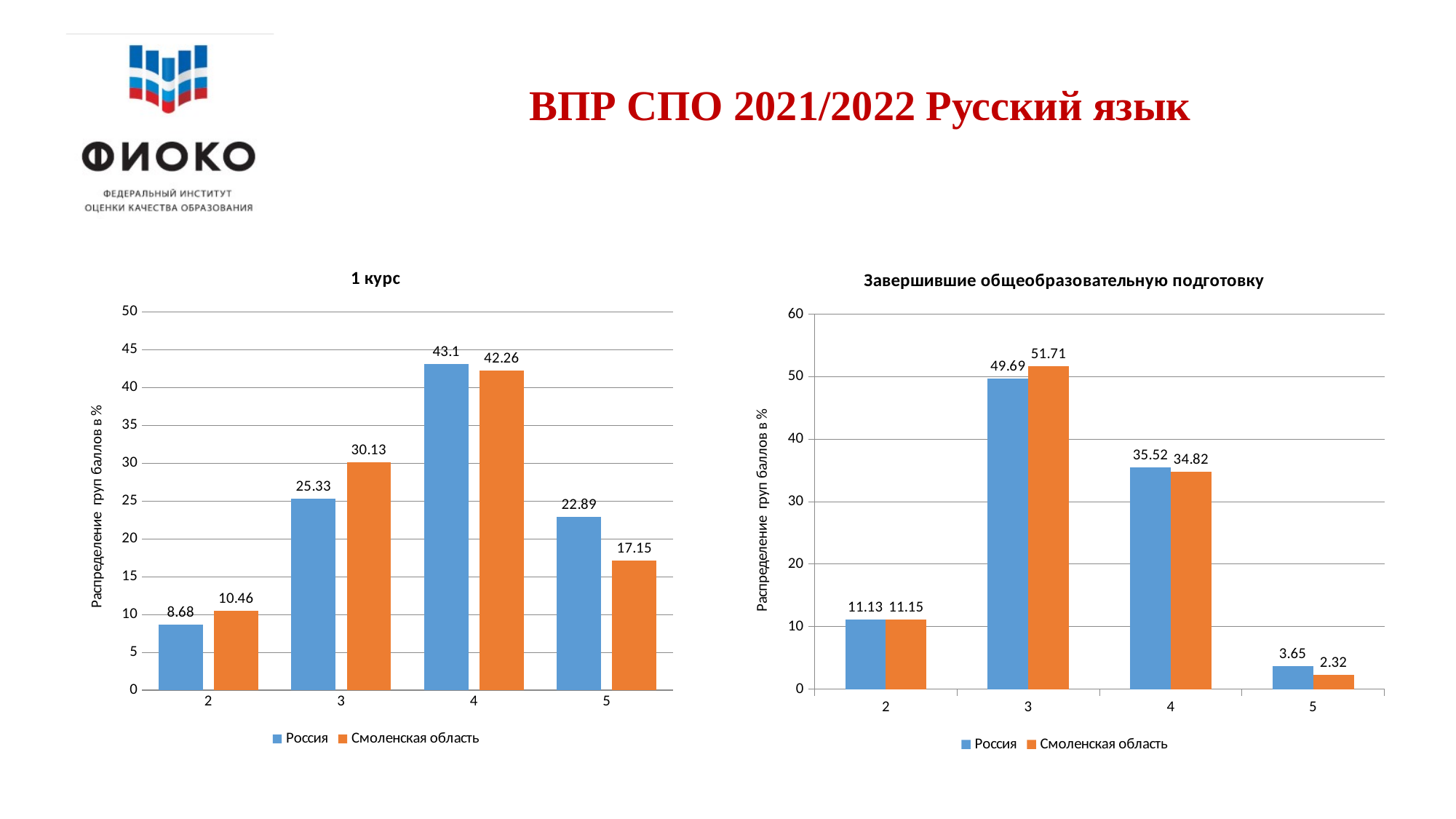
In the chart titled "Завершившие общеобразовательную подготовку", which category has the highest value for Смоленская область? 3 In the chart titled "1 курс", which category has the lowest value for Россия? 2 In the chart titled "1 курс", which is larger at category 5: Россия or Смоленская область? Россия In the chart titled "1 курс", how many categories are shown on the x axis? 4 In the chart titled "1 курс", what is the value for Россия at category 4? 43.1 In the chart titled "Завершившие общеобразовательную подготовку", what is the difference between the Россия and Смоленская область values at category 5? 1.33 In the chart titled "1 курс", what is the difference between the Смоленская область values at category 4 and category 5? 25.11 What kind of chart is the chart titled "1 курс"? Bar chart In the chart titled "Завершившие общеобразовательную подготовку", how many series does the legend list? 2 In the chart titled "Завершившие общеобразовательную подготовку", what is the value for Смоленская область at category 3? 51.71 In the chart titled "Завершившие общеобразовательную подготовку", what is the value for Россия at category 5? 3.65 In the chart titled "1 курс", what is the value for Смоленская область at category 3? 30.13